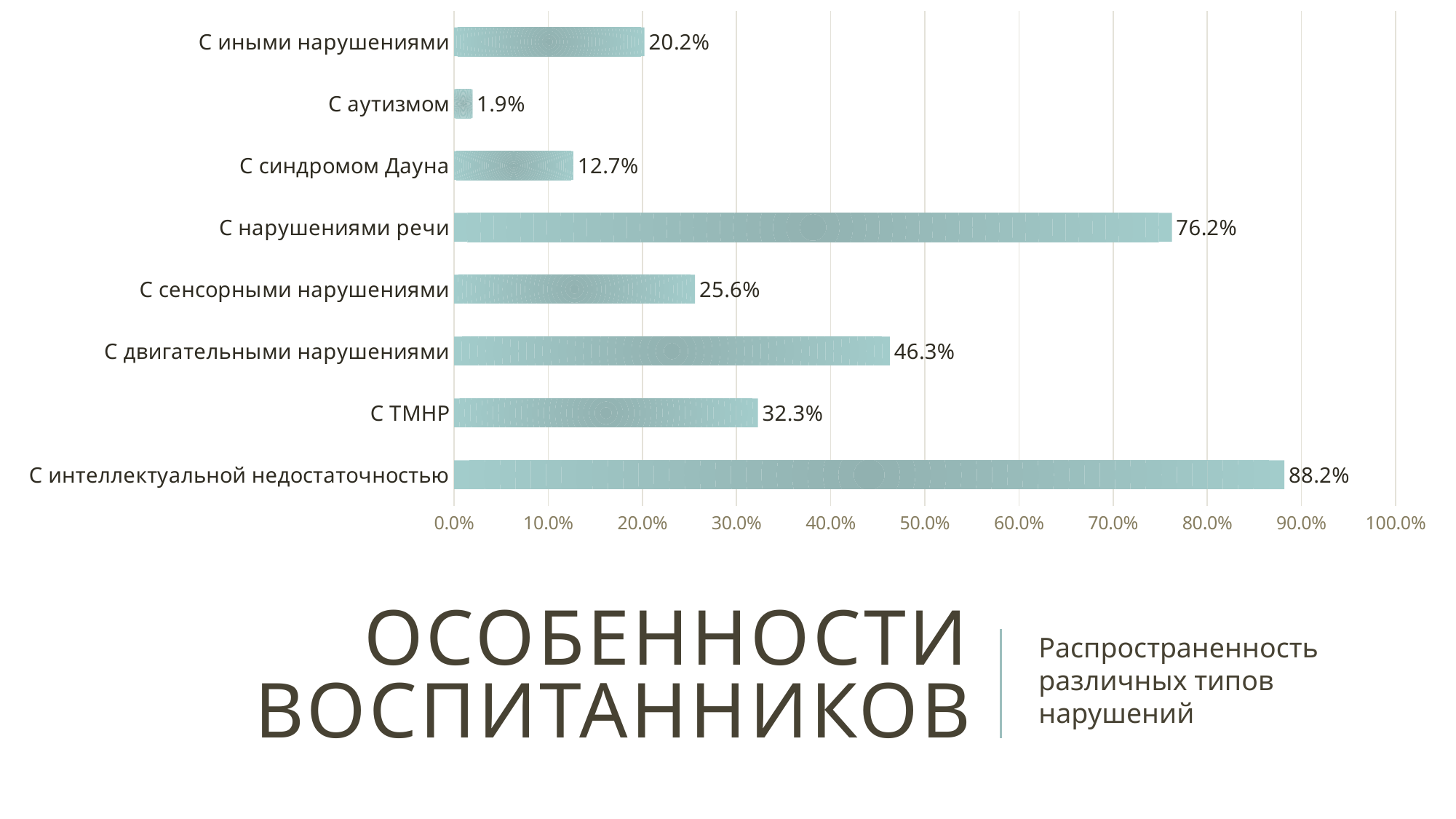
What is the value for С аутизмом? 1.9% Which is larger: the value for С иными нарушениями or the value for С синдромом Дауна? С иными нарушениями Which category has the lowest value? С аутизмом What is the difference between the values for С интеллектуальной недостаточностью and С нарушениями речи? 12.0% What is the value for С нарушениями речи? 76.2% What is the value for С ТМНР? 32.3% What kind of chart is shown on the slide? bar chart What is the subtitle text to the right of the main slide title? Распространенность различных типов нарушений Is the value for С двигательными нарушениями greater or less than 50.0%? less How many categories are shown in the chart? 8 Which category has the highest value? С интеллектуальной недостаточностью What is the difference between the values for С двигательными нарушениями and С сенсорными нарушениями? 20.7%